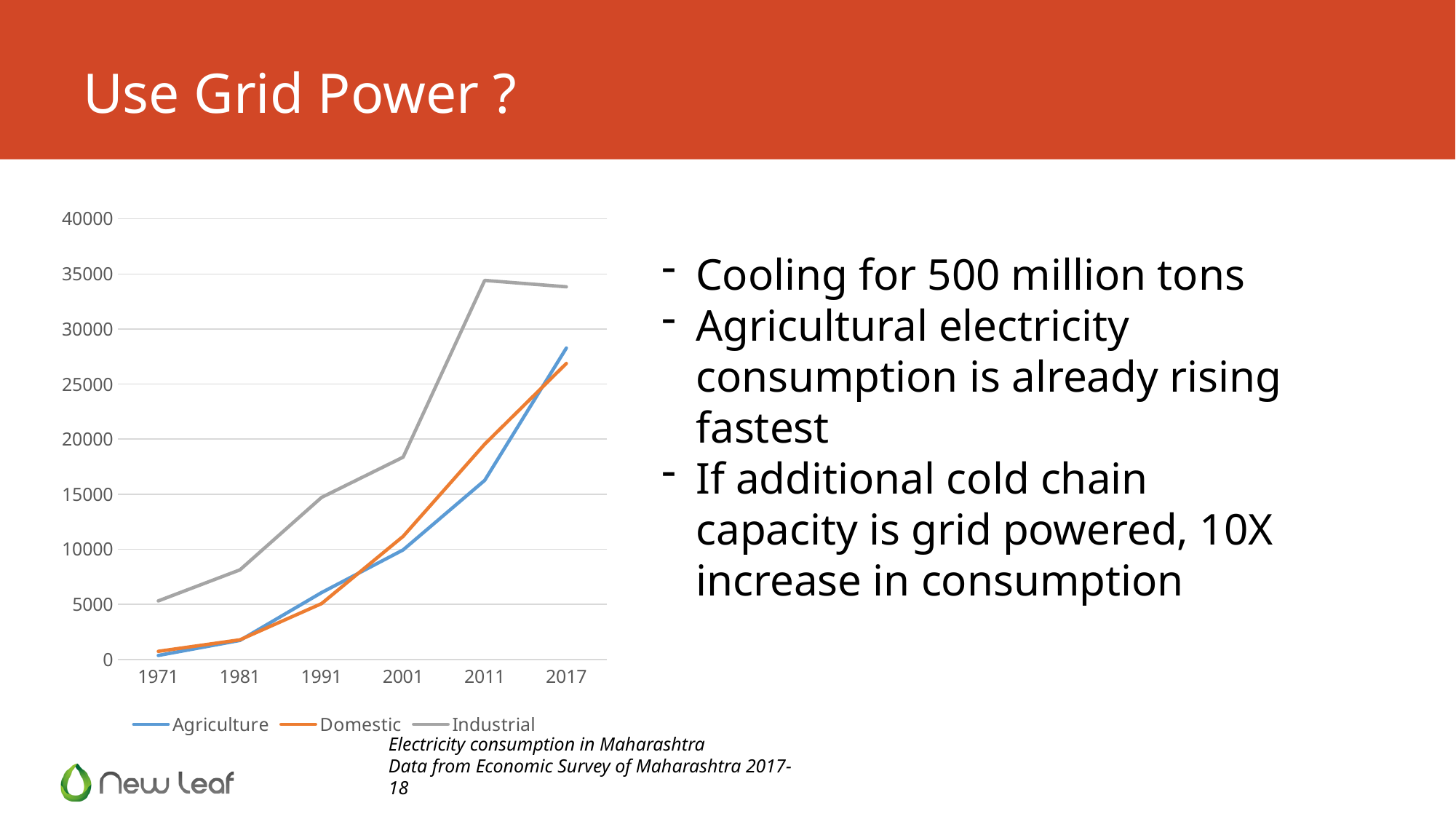
What kind of chart is shown on the slide? Line chart Is the Agriculture value for 2017 greater or less than 25000? greater How many years are plotted along the x axis of the chart? 6 Does the Agriculture series rise or fall from 1971 to 2017? Rises Which series has the highest value in 2017? Industrial What are the three series named in the chart's legend? Agriculture, Domestic, Industrial How many series does the chart's legend list? 3 Which series has the lowest value in 2011? Agriculture Is the Industrial value for 2011 greater or less than 30000? greater In 2011, which is larger: the Industrial value or the Domestic value? Industrial Is the Industrial value for 2001 greater or less than 20000? less